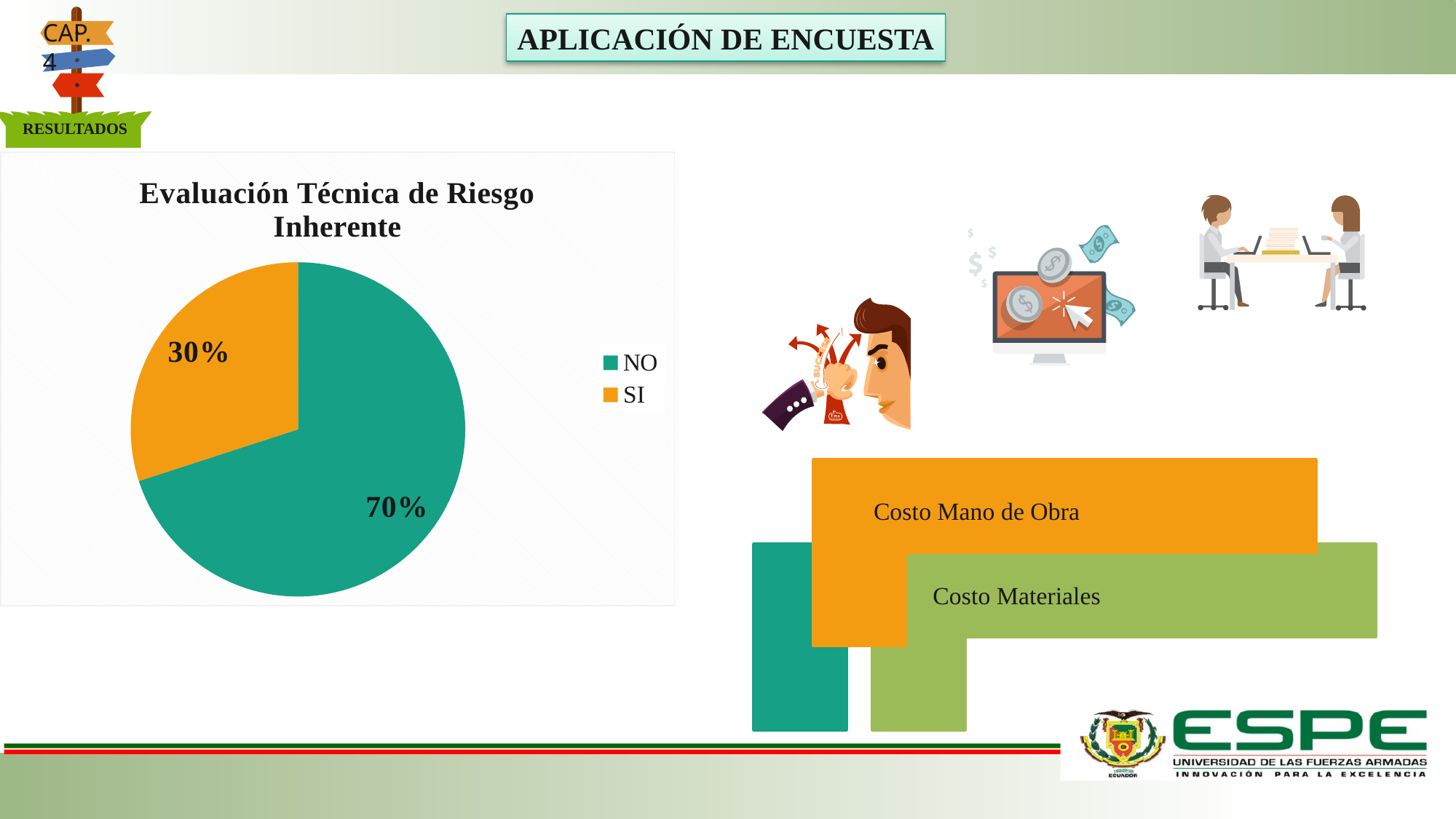
Which category has the largest share of the pie? NO What percentage of the pie corresponds to NO? 70% What percentage of the pie corresponds to SI? 30% What colour is the slice for SI? orange What is the difference in percentage points between NO and SI? 40 How many entries does the legend list? 2 How many slices does the pie chart have? 2 Which is larger, the share for NO or the share for SI? NO What is the title of the chart? Evaluación Técnica de Riesgo Inherente Which category has the smallest share of the pie? SI What kind of chart is shown on the slide? pie chart